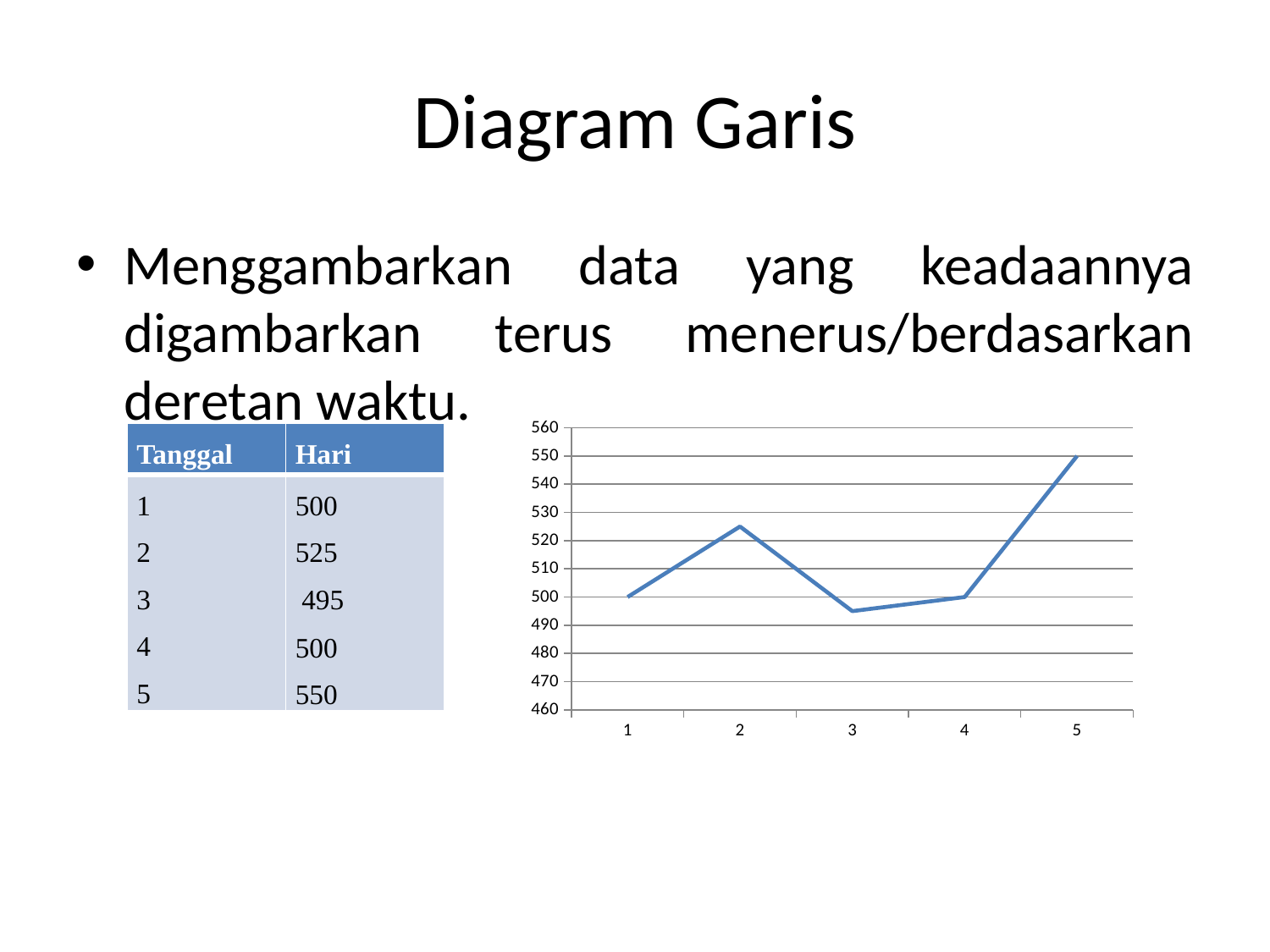
What is the value plotted at x = 3 on the line chart? 495 What is the value plotted at x = 5 on the line chart? 550 What is the value plotted at x = 2 on the line chart? 525 At which x value does the line chart reach its lowest point? 3 How many data points are plotted on the line chart? 5 What is the value plotted at x = 1 on the line chart? 500 Which is larger on the line chart, the value at x = 2 or the value at x = 4? x = 2 Is the value at x = 3 on the line chart greater or less than 500? less What is the difference between the values at x = 5 and x = 1 on the line chart? 50 Does the line rise or fall between x = 4 and x = 5 on the line chart? rise What kind of chart is shown on the slide? line chart At which x value does the line chart reach its highest point? 5